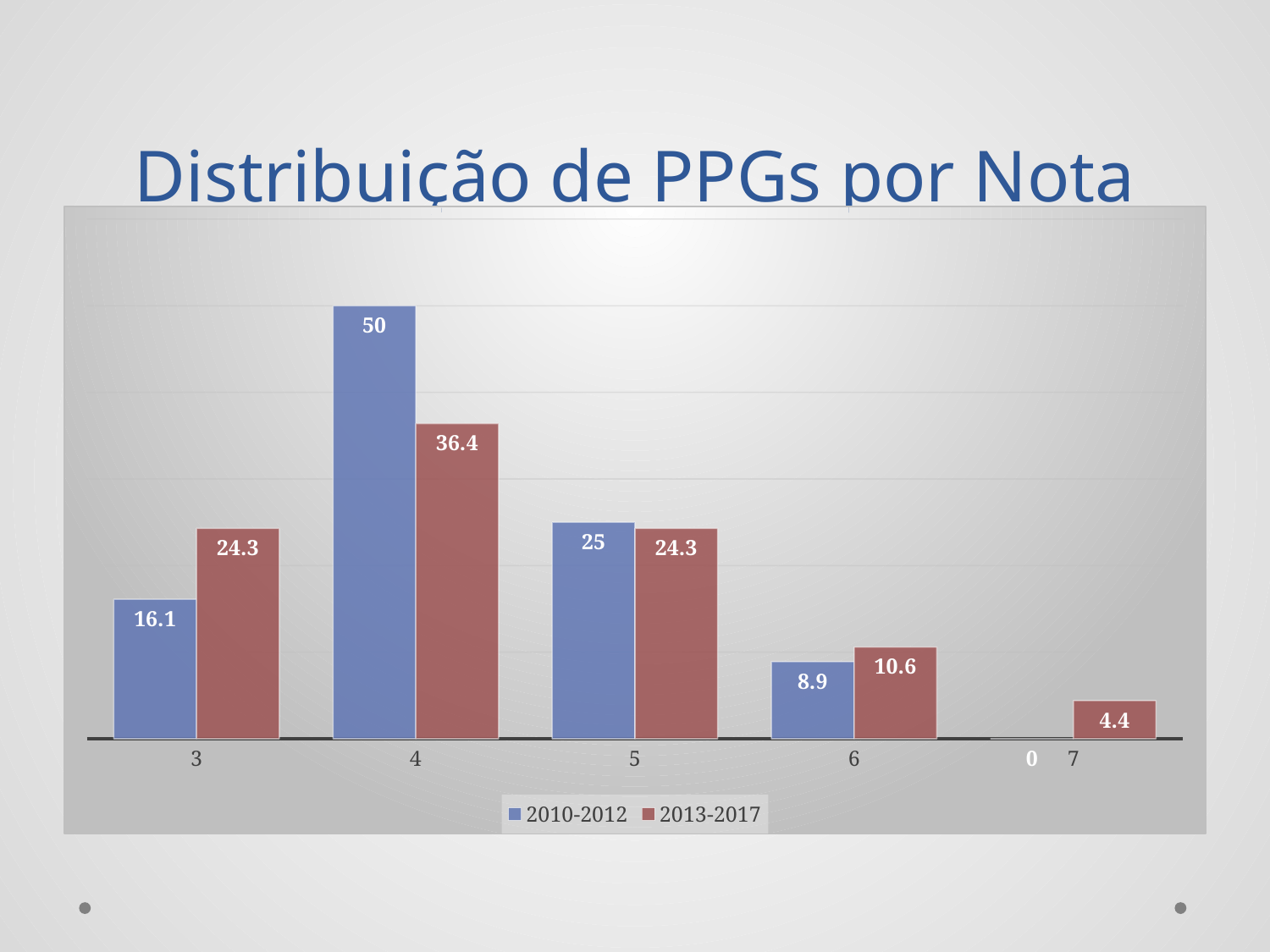
What is the difference between the 2010-2012 and 2013-2017 values at nota 4? 13.6 Which series has the larger value at nota 6, 2010-2012 or 2013-2017? 2013-2017 How many series does the legend list? 2 Which nota has the lowest value for the 2013-2017 series? 7 What is the value for 2010-2012 at nota 4? 50 Which nota has the highest value for the 2010-2012 series? 4 What is the value for 2013-2017 at nota 3? 24.3 What is the value for 2010-2012 at nota 7? 0 What kind of chart is shown on the slide? Bar chart What is the value for 2013-2017 at nota 7? 4.4 How many nota categories are shown on the x axis? 5 What is the title of the chart? Distribuição de PPGs por Nota